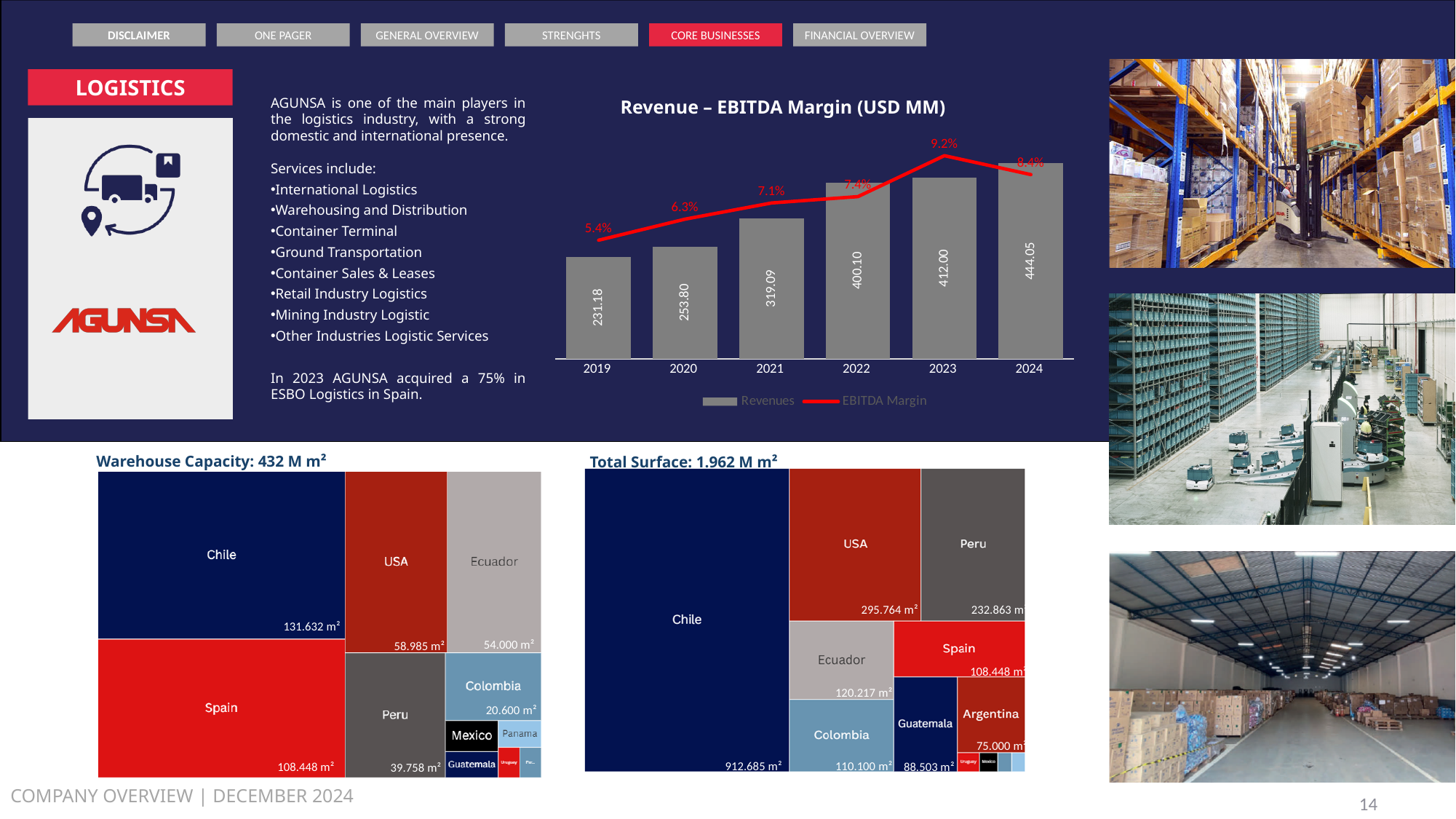
In the Total Surface chart, which is larger, USA or Ecuador? USA In the Revenue – EBITDA Margin chart, does revenue rise or fall from 2019 to 2024? rise In the Total Surface chart, what is the value for Chile? 912.685 m² In the Revenue – EBITDA Margin chart, how many years are shown on the x axis? 6 In the Warehouse Capacity chart, what is the value for Spain? 108.448 m² In the Warehouse Capacity chart, which country has the largest area? Chile In the Revenue – EBITDA Margin chart, what is the difference in revenue between 2024 and 2019? 212.87 In the Revenue – EBITDA Margin chart, how many series does the legend list? 2 In the Revenue – EBITDA Margin chart, which year had the lowest EBITDA margin? 2019 In the Revenue – EBITDA Margin chart, which year had the highest revenue? 2024 In the Revenue – EBITDA Margin chart, what was the revenue in 2022? 400.10 In the Revenue – EBITDA Margin chart, what was the EBITDA margin in 2023? 9.2%